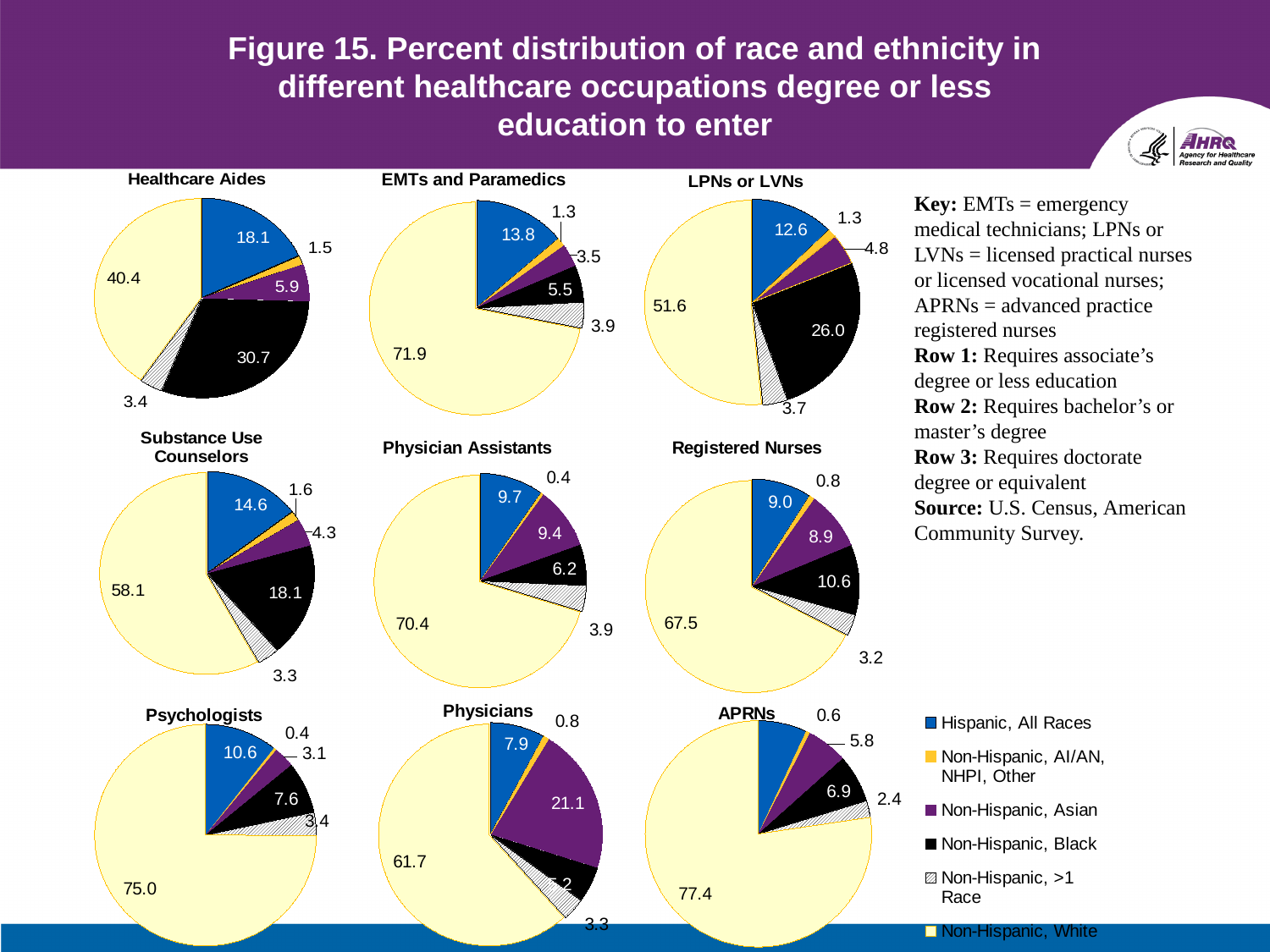
What kind of charts are shown on the slide? Pie charts In the Substance Use Counselors pie chart, what is the difference between the Non-Hispanic, White value and the Non-Hispanic, Black value? 40.0 In the APRNs pie chart, what is the value for Non-Hispanic, White? 77.4 How many pie charts are on the slide? 9 In the Registered Nurses pie chart, which group has the largest share? Non-Hispanic, White In the Physicians pie chart, what is the value for Non-Hispanic, Asian? 21.1 In the LPNs or LVNs pie chart, what is the value for Hispanic, All Races? 12.6 In the EMTs and Paramedics pie chart, what is the value for Non-Hispanic, White? 71.9 In the Healthcare Aides pie chart, what percentage is Non-Hispanic, Black? 30.7 How many series does the legend list? 6 In the Psychologists pie chart, which is larger: Hispanic, All Races or Non-Hispanic, Black? Hispanic, All Races In the Physician Assistants pie chart, which group has the smallest share? Non-Hispanic, AI/AN, NHPI, Other